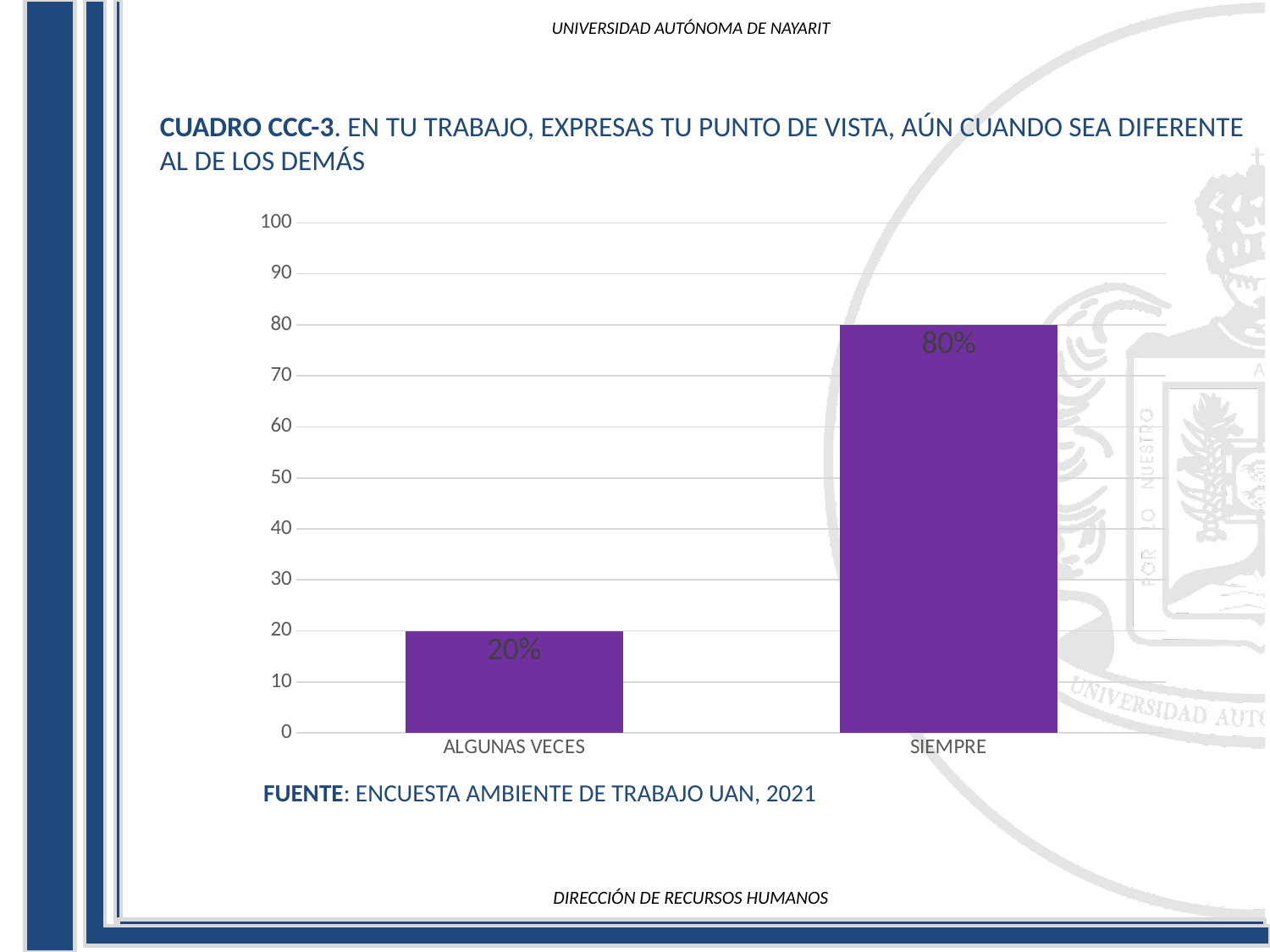
Is the value for SIEMPRE greater or less than 50? greater What is the value for SIEMPRE? 80% What is the difference between the values for SIEMPRE and ALGUNAS VECES? 60% What kind of chart is shown on the slide? Bar chart Which category has the lowest value? ALGUNAS VECES Which category has the highest value? SIEMPRE Is the value for ALGUNAS VECES greater or less than 30? less How many categories are shown on the x axis? 2 What is the maximum value shown on the y axis? 100 What source is cited below the chart? ENCUESTA AMBIENTE DE TRABAJO UAN, 2021 Which is larger, the value for ALGUNAS VECES or the value for SIEMPRE? SIEMPRE What is the value for ALGUNAS VECES? 20%